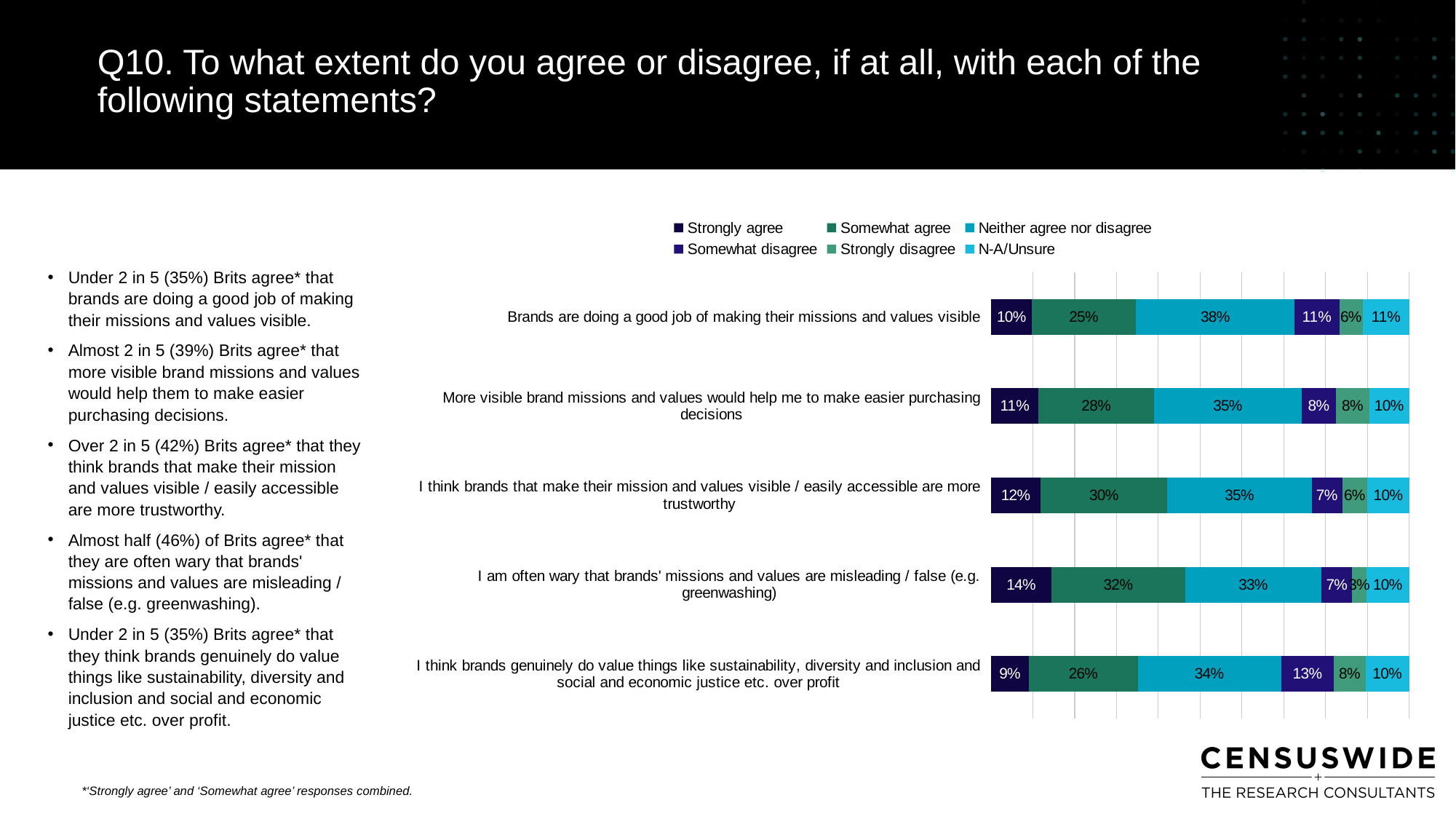
How many series does the legend list? 6 What is the combined 'Strongly agree' and 'Somewhat agree' percentage for 'I think brands that make their mission and values visible / easily accessible are more trustworthy'? 42% What is the 'Strongly disagree' value for 'I am often wary that brands' missions and values are misleading / false (e.g. greenwashing)'? 3% What percentage of respondents somewhat agree that they are often wary that brands' missions and values are misleading / false (e.g. greenwashing)? 32% What percentage of respondents strongly agree that brands are doing a good job of making their missions and values visible? 10% Which statement has the lowest 'Strongly agree' percentage? I think brands genuinely do value things like sustainability, diversity and inclusion and social and economic justice etc. over profit What is the 'Neither agree nor disagree' value for the statement 'I think brands genuinely do value things like sustainability, diversity and inclusion and social and economic justice etc. over profit'? 34% How many statements are plotted in the chart? 5 What kind of chart is shown on the slide? Stacked bar chart Which statement has the highest 'Strongly agree' percentage? I am often wary that brands' missions and values are misleading / false (e.g. greenwashing) What is the difference between the 'Somewhat agree' percentages for 'I am often wary that brands' missions and values are misleading / false' and 'Brands are doing a good job of making their missions and values visible'? 7 percentage points Which is larger: the 'Somewhat disagree' value for 'I think brands genuinely do value things like sustainability...' or for 'More visible brand missions and values would help me to make easier purchasing decisions'? I think brands genuinely do value things like sustainability, diversity and inclusion and social and economic justice etc. over profit